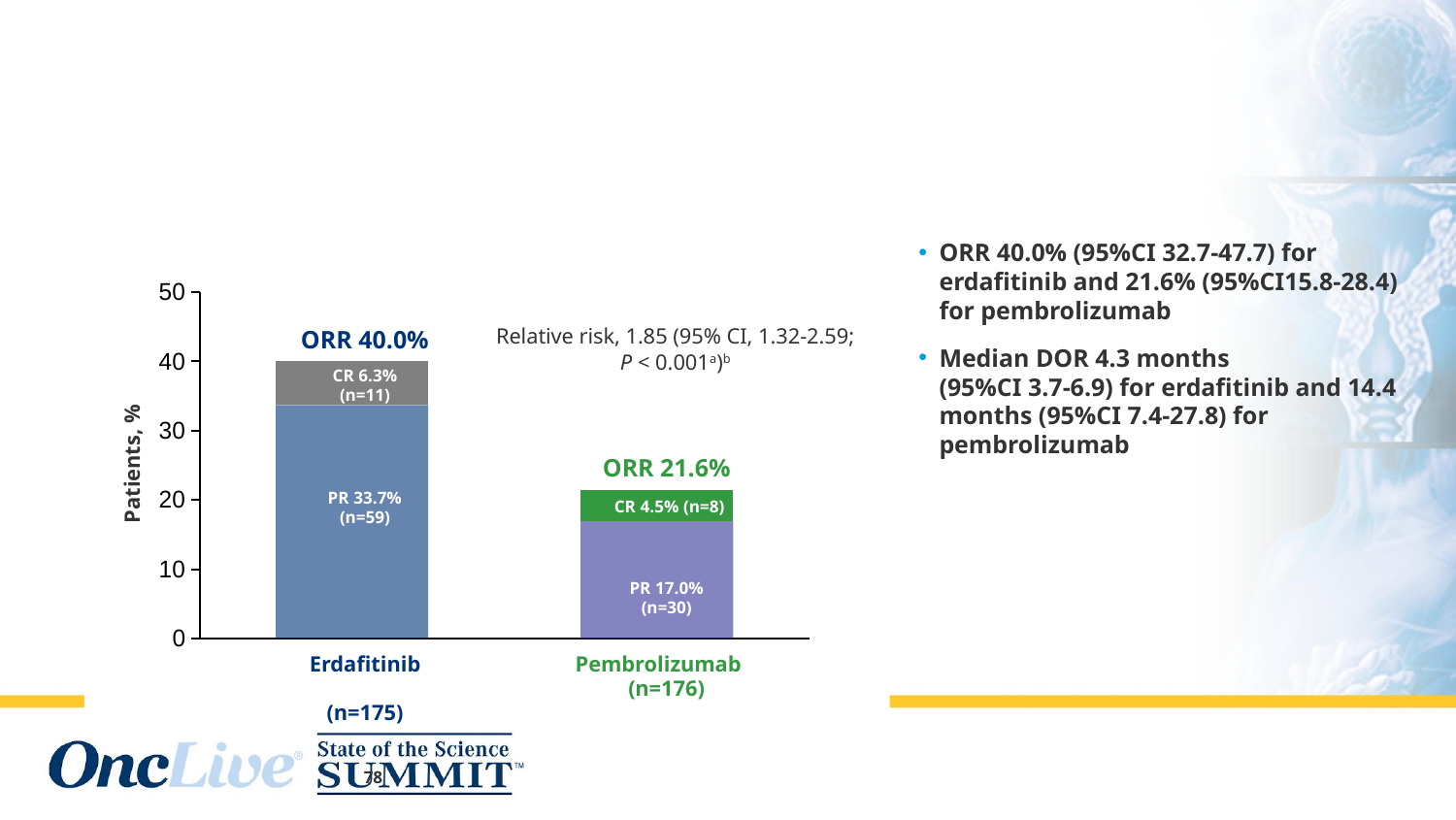
How many treatment categories are shown on the x axis? 2 How many patients had a PR with Pembrolizumab (n)? 30 What is the ORR shown above the Erdafitinib bar? 40.0% What is the PR value for Erdafitinib? 33.7% Which treatment has the lower CR percentage? Pembrolizumab What is the difference in ORR between Erdafitinib and Pembrolizumab? 18.4% What is the label of the y axis? Patients, % Is the PR value for Erdafitinib larger than the PR value for Pembrolizumab? Yes Which treatment has the higher ORR? Erdafitinib What kind of chart is shown on the slide? Stacked bar chart What is the ORR shown above the Pembrolizumab bar? 21.6% What is the CR value for Pembrolizumab? 4.5%